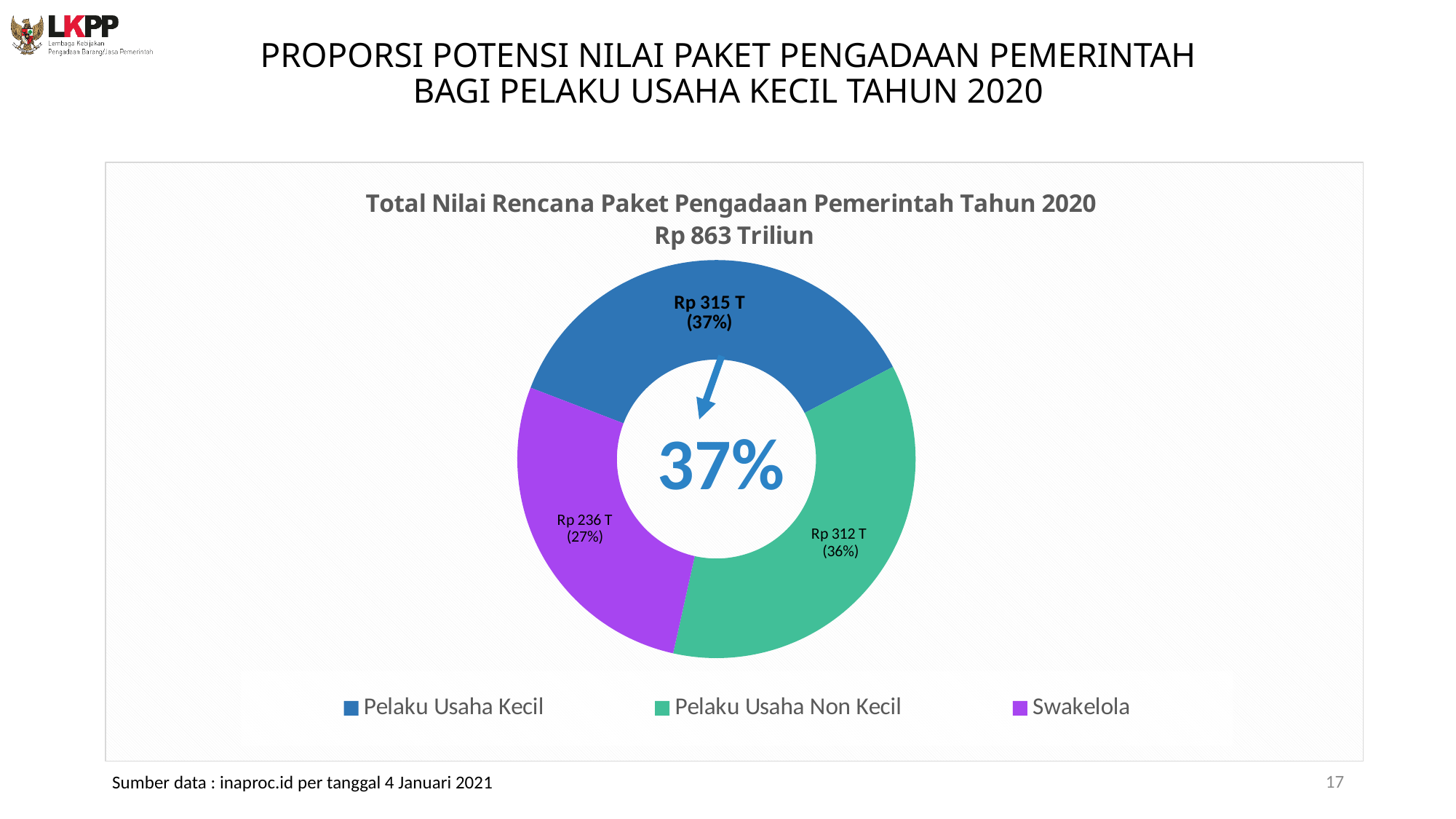
What share of the total does Swakelola represent? 27% Which is larger, the value for Pelaku Usaha Non Kecil or the value for Swakelola? Pelaku Usaha Non Kecil What is the value for Pelaku Usaha Kecil? Rp 315 T What share of the total does Pelaku Usaha Kecil represent? 37% Which category has the largest value? Pelaku Usaha Kecil How many categories are shown in the chart? 3 What is the value for Swakelola? Rp 236 T What kind of chart is shown on the slide? Doughnut chart What total value is stated in the chart title? Rp 863 Triliun What is the value for Pelaku Usaha Non Kecil? Rp 312 T What is the difference between the values for Pelaku Usaha Kecil and Swakelola? Rp 79 T Which category has the smallest value? Swakelola